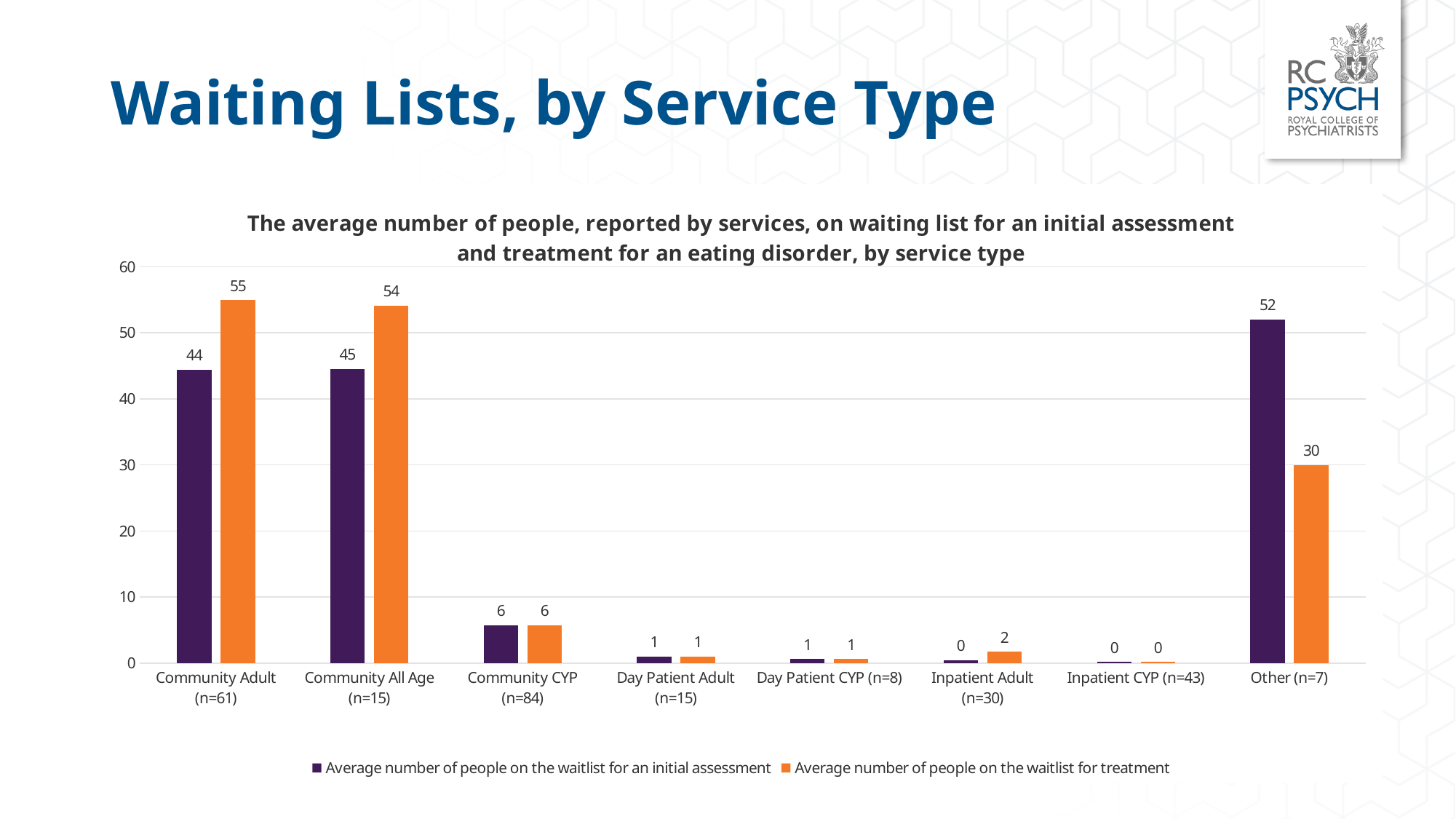
What kind of chart is shown on the slide? Bar chart What colour are the bars for the average number of people on the waitlist for treatment? Orange How many service types are shown on the x axis? 8 Which service type has the highest average number of people on the waitlist for treatment? Community Adult (n=61) What is the average number of people on the waitlist for an initial assessment for Community All Age (n=15)? 45 For Community All Age (n=15), which is larger: the waitlist for an initial assessment or the waitlist for treatment? Waitlist for treatment How many series does the legend list? 2 What is the difference between the waitlist for treatment and the waitlist for an initial assessment for Other (n=7)? 22 What is the average number of people on the waitlist for an initial assessment for Other (n=7)? 52 Which service type has the highest average number of people on the waitlist for an initial assessment? Other (n=7) What is the difference between the waitlist for treatment values for Community Adult (n=61) and Other (n=7)? 25 What is the average number of people on the waitlist for treatment for Community Adult (n=61)? 55